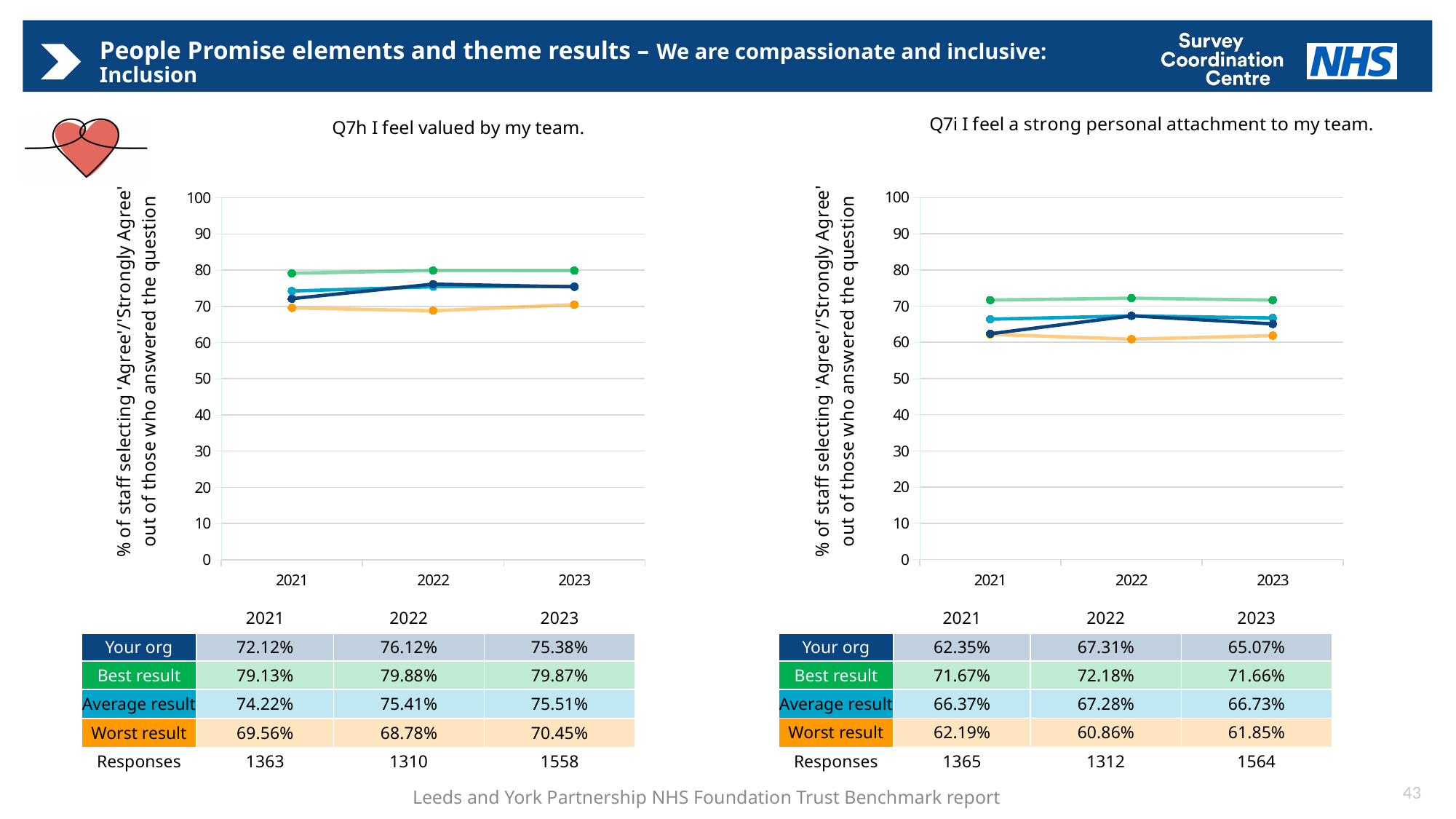
How many years are shown on the x axis of the chart 'Q7h I feel valued by my team.'? 3 In the chart 'Q7h I feel valued by my team.', what is the value for Your org in 2022? 76.12% In the chart 'Q7h I feel valued by my team.', what is the difference between the Best result and Your org values in 2023? 4.49 percentage points What kind of chart is 'Q7h I feel valued by my team.'? Line chart In the chart 'Q7i I feel a strong personal attachment to my team.', in which year is the Worst result value lowest? 2022 In the chart 'Q7i I feel a strong personal attachment to my team.', is the Best result value for 2023 greater or less than 70? greater In the chart 'Q7h I feel valued by my team.', how many responses were recorded in 2023? 1558 In the chart 'Q7h I feel valued by my team.', in which year is the Your org value highest? 2022 In the chart 'Q7h I feel valued by my team.', which is larger in 2021: the Average result or the Your org value? Average result In the chart 'Q7i I feel a strong personal attachment to my team.', what is the Worst result value in 2022? 60.86% In the chart 'Q7i I feel a strong personal attachment to my team.', does the Your org value rise or fall from 2021 to 2022? Rise How many series (lines) are plotted in the chart 'Q7i I feel a strong personal attachment to my team.'? 4